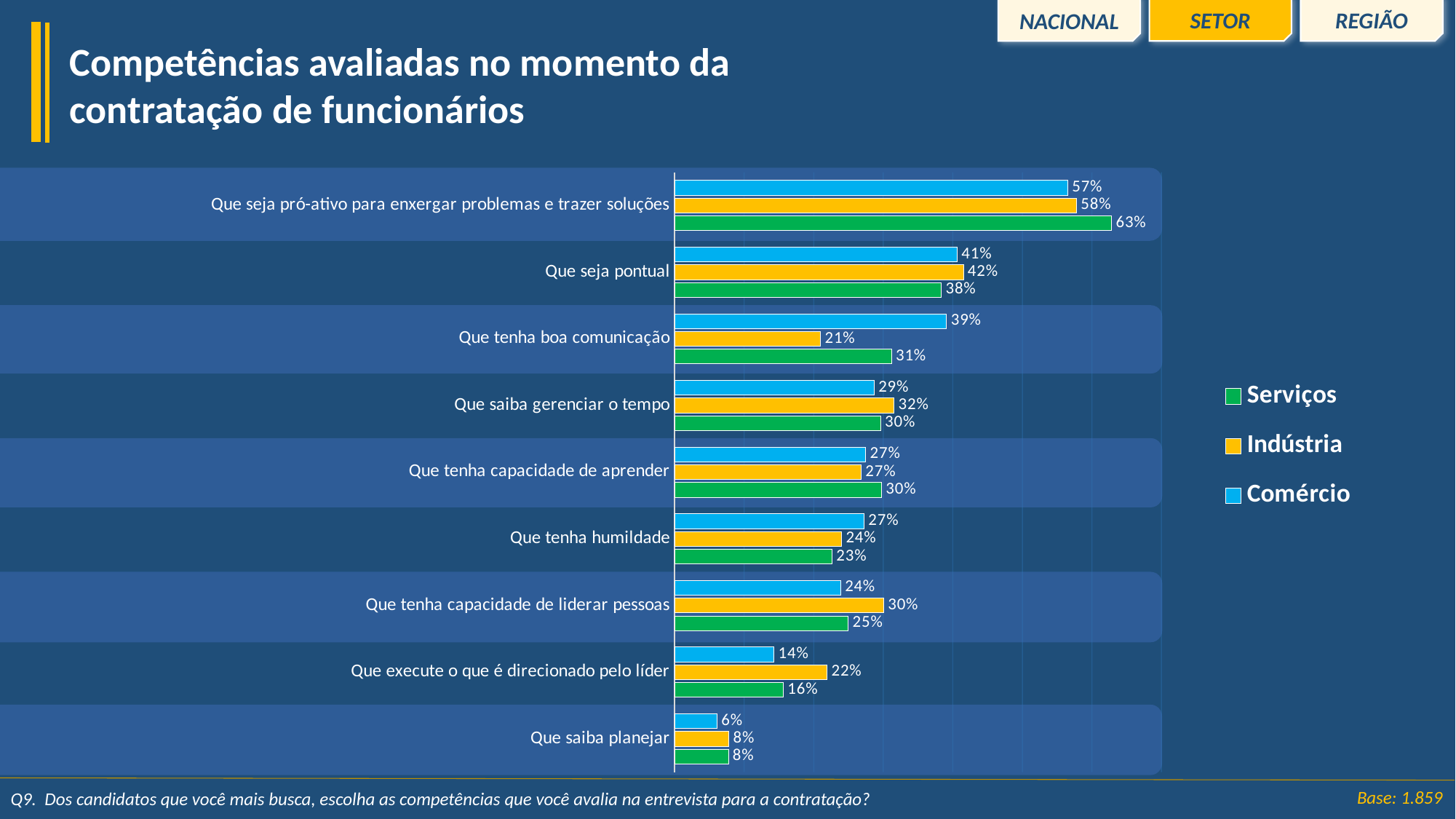
What is the Indústria value for "Que tenha boa comunicação"? 21% What is the Comércio value for "Que execute o que é direcionado pelo líder"? 14% What kind of chart is shown on the slide? Bar chart Which category has the lowest Indústria value? Que saiba planejar Which category has the highest Comércio value? Que seja pró-ativo para enxergar problemas e trazer soluções What is the difference between the Serviços and Comércio values for "Que seja pontual"? 3% For "Que tenha capacidade de liderar pessoas", which series has the larger value, Indústria or Comércio? Indústria What is the Serviços value for "Que seja pró-ativo para enxergar problemas e trazer soluções"? 63% How many competency categories are shown on the chart? 9 Which colour represents the Indústria series in the legend? Yellow What is the difference between the Comércio and Indústria values for "Que tenha boa comunicação"? 18% How many series does the legend list? 3